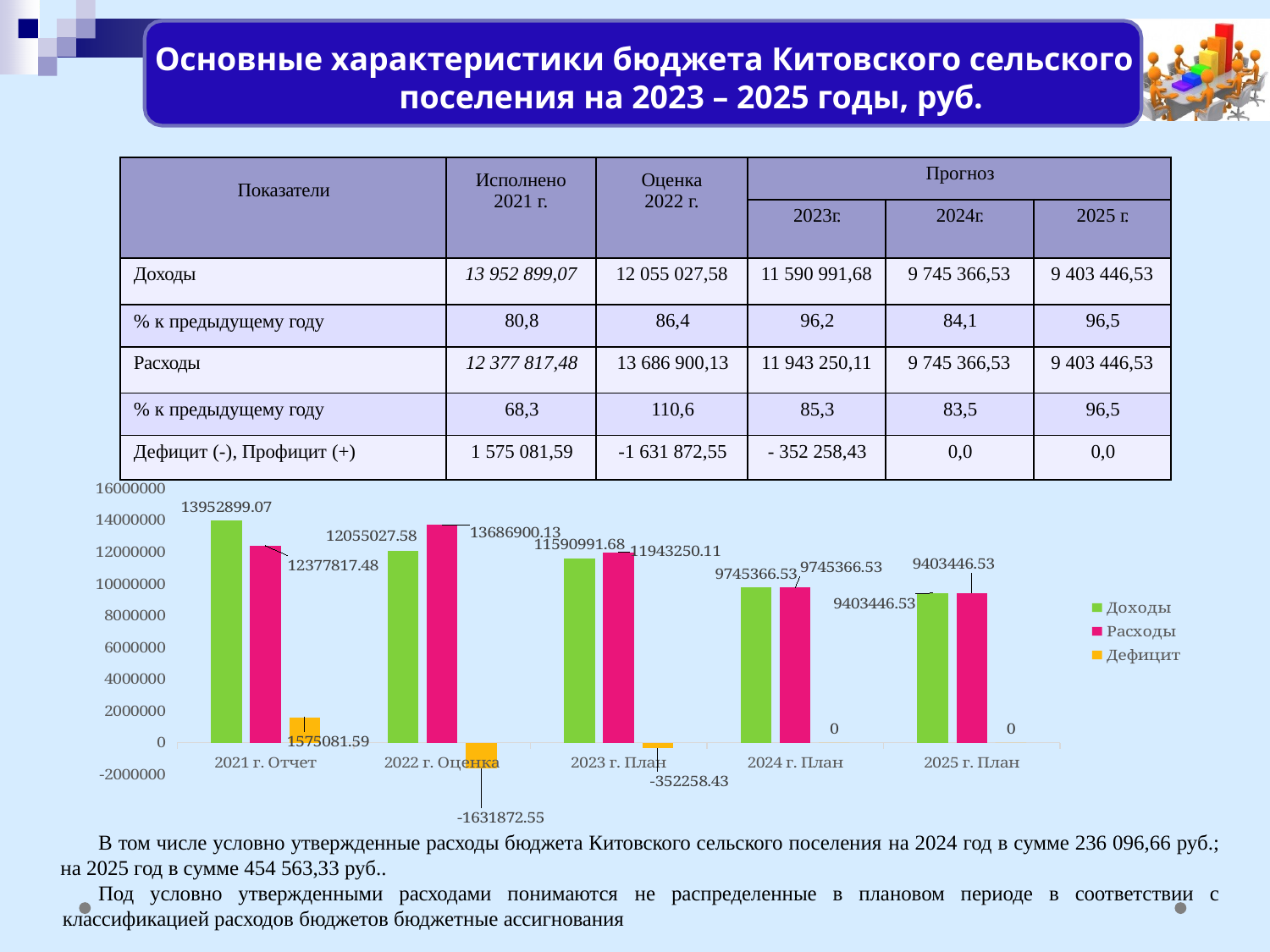
What kind of chart is shown on the slide? bar chart How many categories are shown along the x axis of the chart? 5 What is the value of Доходы for 2021 г. Отчет in the chart? 13952899.07 What is the value of Дефицит for 2023 г. План in the chart? -352258.43 Which is larger in the chart for 2022 г. Оценка: Доходы or Расходы? Расходы What is the value of Расходы for 2022 г. Оценка in the chart? 13686900.13 What is the difference between Доходы and Расходы for 2021 г. Отчет in the chart? 1575081.59 Which category has the highest Доходы value in the chart? 2021 г. Отчет Which category has the lowest Расходы value in the chart? 2025 г. План Do the Доходы values rise or fall from 2021 г. Отчет to 2025 г. План in the chart? fall How many series does the chart legend list? 3 What is the value of Дефицит for 2022 г. Оценка in the chart? -1631872.55